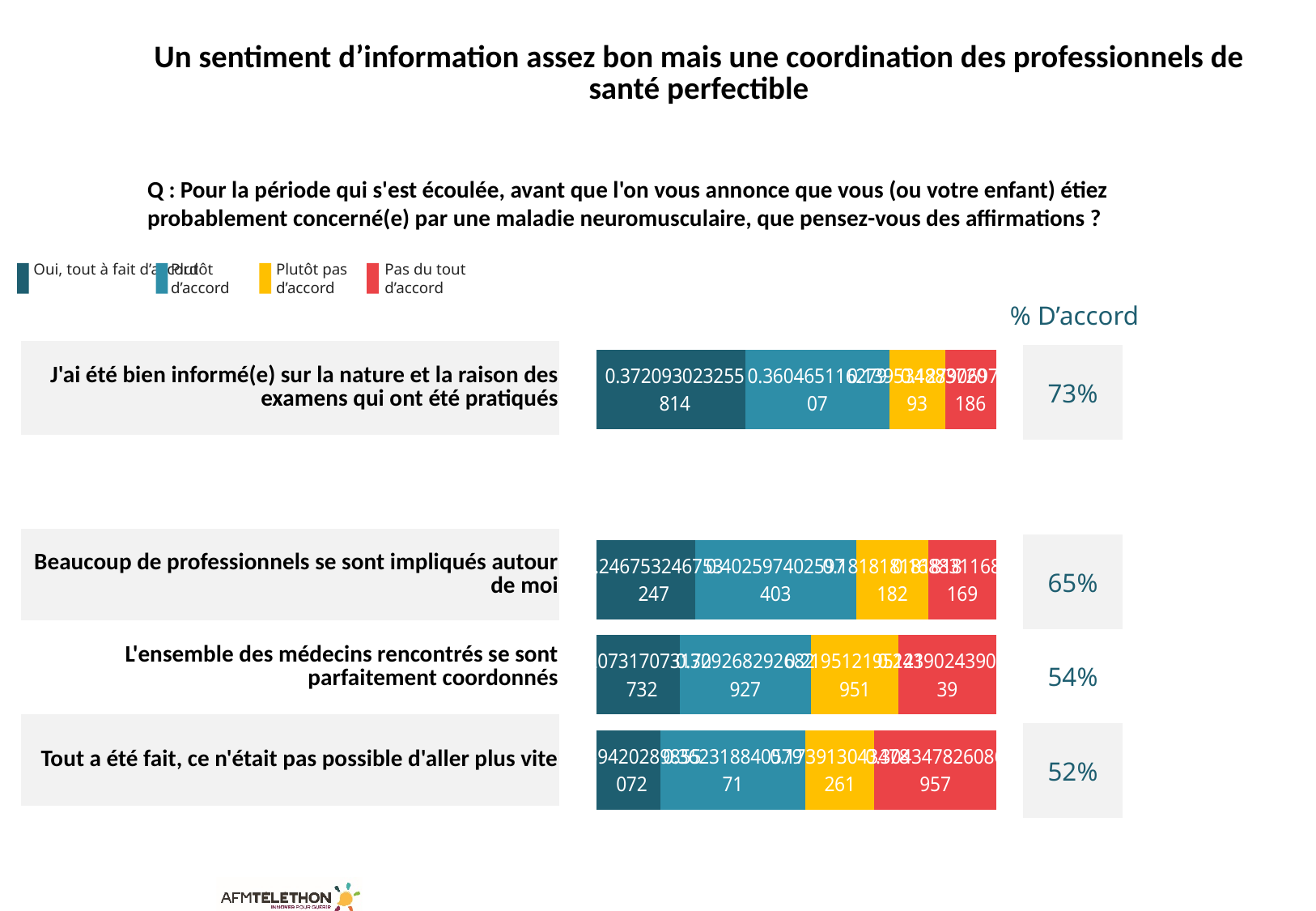
What kind of chart is shown on the slide? Stacked bar chart What is the % D'accord shown for "L'ensemble des médecins rencontrés se sont parfaitement coordonnés"? 54% What is the % D'accord shown for "J'ai été bien informé(e) sur la nature et la raison des examens qui ont été pratiqués"? 73% Which statement has the lowest % D'accord? Tout a été fait, ce n'était pas possible d'aller plus vite Which legend entry is shown in red? Pas du tout d'accord How many series does the legend list? 4 What is the difference in % D'accord between "J'ai été bien informé(e)..." and "Tout a été fait, ce n'était pas possible d'aller plus vite"? 21 percentage points What is the % D'accord shown for "Tout a été fait, ce n'était pas possible d'aller plus vite"? 52% What is the % D'accord shown for "Beaucoup de professionnels se sont impliqués autour de moi"? 65% How many statements (categories) are plotted in the chart? 4 Which has a higher % D'accord: "Beaucoup de professionnels se sont impliqués autour de moi" or "L'ensemble des médecins rencontrés se sont parfaitement coordonnés"? Beaucoup de professionnels se sont impliqués autour de moi Which statement has the highest % D'accord? J'ai été bien informé(e) sur la nature et la raison des examens qui ont été pratiqués